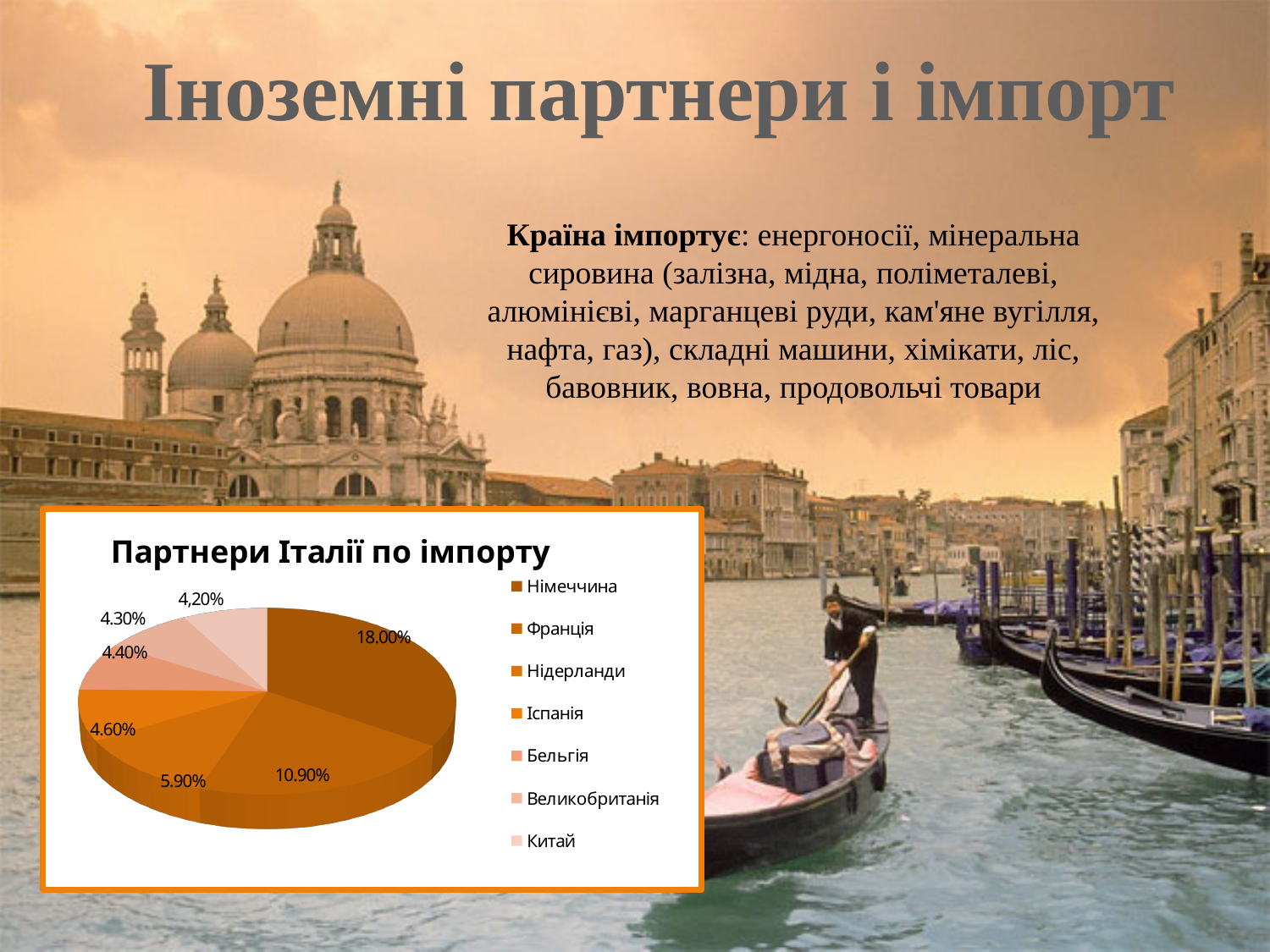
What is the value for Китай? 4,20% Which is larger, the value for Франція or the value for Нідерланди? Франція How many entries does the legend list? 7 What is the value for Німеччина? 18.00% Which country has the smallest share of the pie? Китай What is the value for Нідерланди? 5.90% What is the difference between the values for Німеччина and Франція? 7.10% What type of chart is shown on the slide? Pie chart How many countries are shown in the pie chart? 7 Which country has the largest share of the pie? Німеччина What is the value for Франція? 10.90% What is the title of the chart? Партнери Італії по імпорту